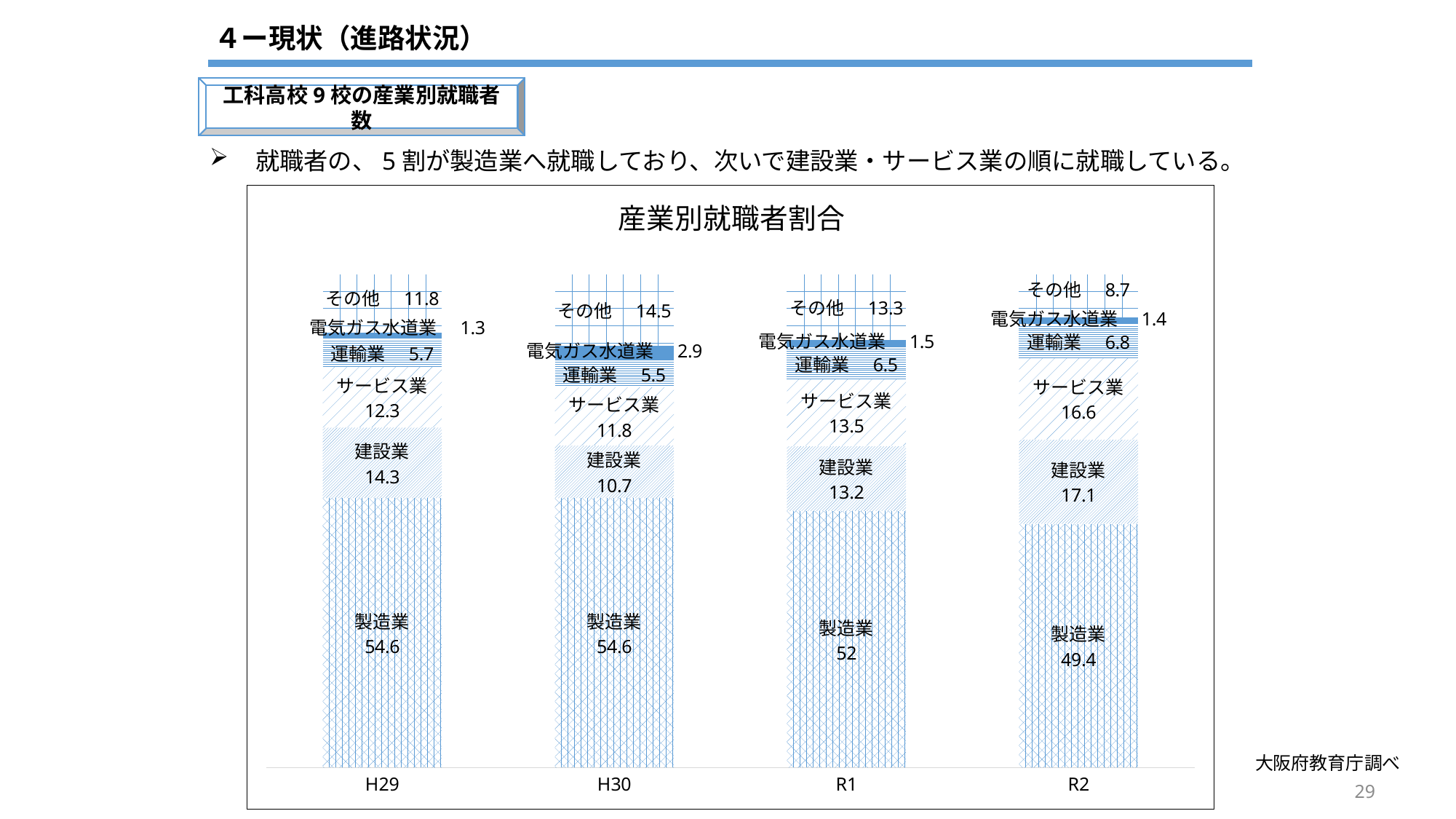
What type of chart is shown on the slide? stacked bar chart How many year categories are shown on the x axis of the chart? 4 What is the value for 製造業 in H29? 54.6 What is the value for 建設業 in R2? 17.1 What is the value for 電気ガス水道業 in H30? 2.9 What is the value for その他 in R1? 13.3 What is the title of the chart? 産業別就職者割合 In which year is the value for 建設業 the highest? R2 Does the value for 製造業 rise or fall from H30 to R2? fall What is the difference between the 製造業 values for H29 and R2? 5.2 Which is larger in R1, サービス業 or 建設業? サービス業 In which year is the value for 製造業 the lowest? R2